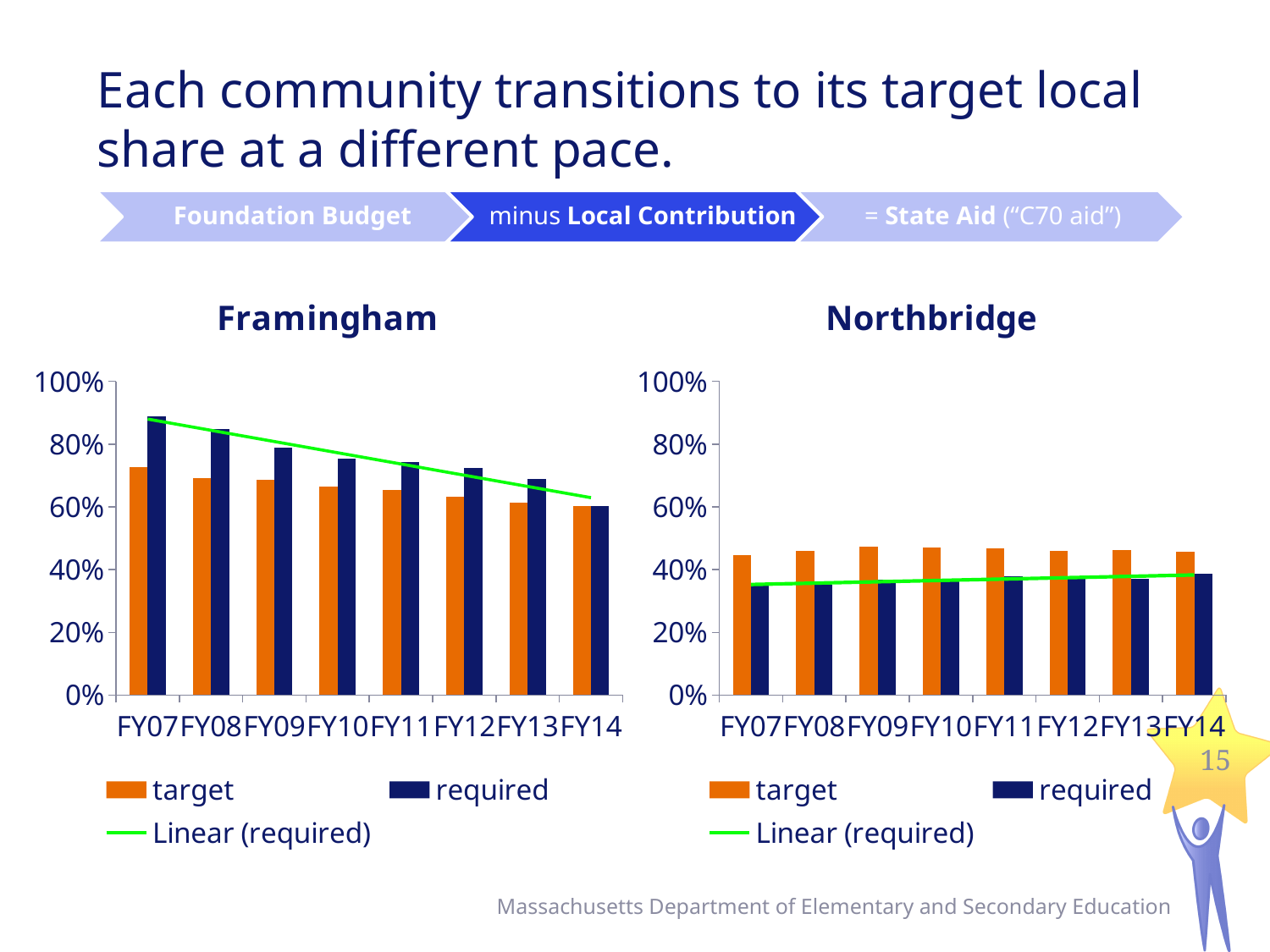
In the Framingham chart, which is larger for FY07, target or required? required In the Framingham chart, is the required value for FY07 greater or less than 80%? greater In the Framingham chart, do the required values rise or fall from FY07 to FY14? fall How many fiscal years are shown on the x axis of the Northbridge chart? 8 In the Framingham chart, which fiscal year has the lowest required value? FY14 In the Northbridge chart, is the required value for FY07 greater or less than 40%? less In the Northbridge chart, which is larger for FY07, target or required? target How many entries does the legend of the Framingham chart list? 3 What kind of chart is the Framingham chart? bar chart In the Framingham chart, which fiscal year has the highest required value? FY07 In the Framingham chart, is the target value for FY07 greater or less than 80%? less